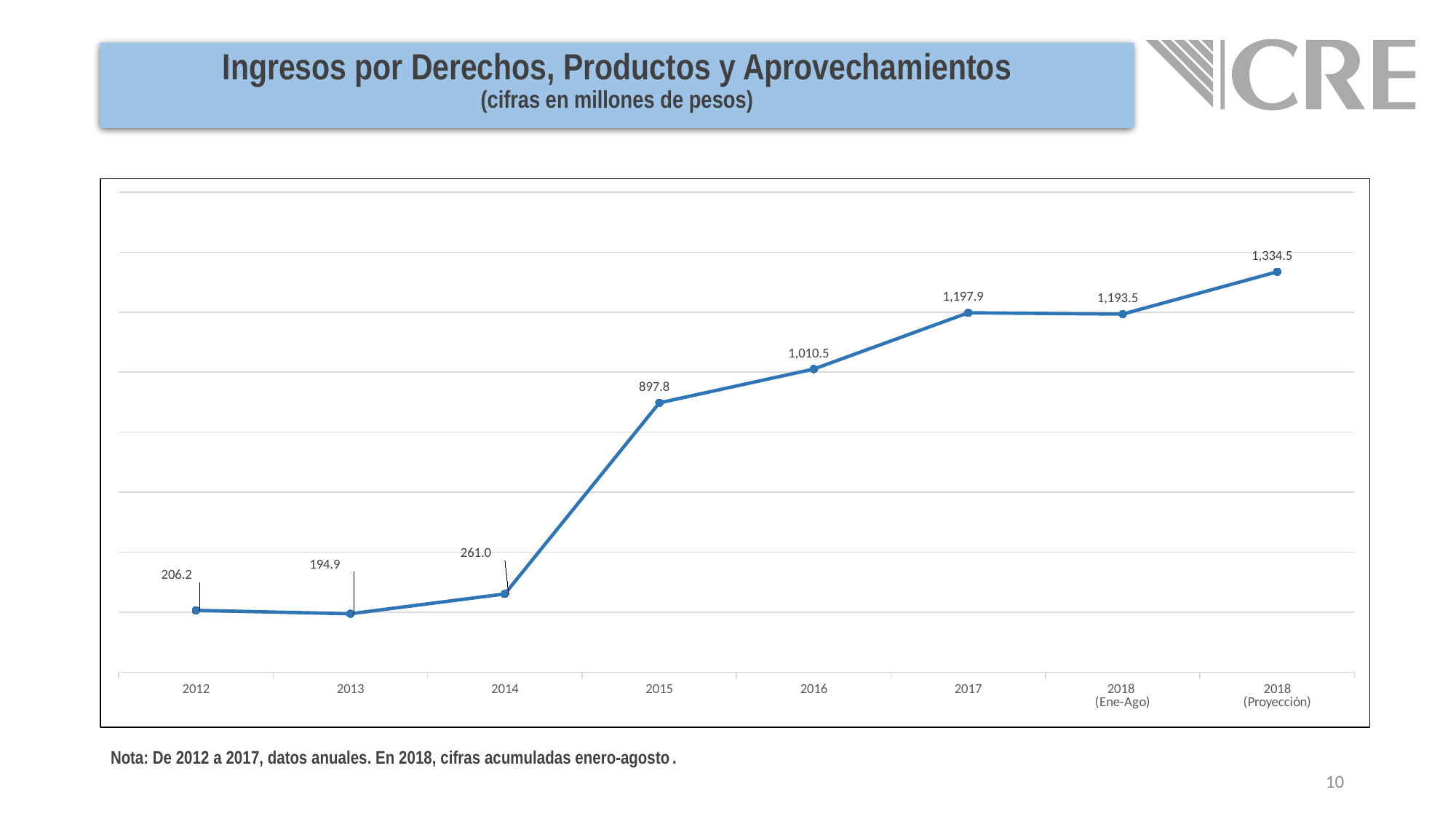
What is the value for 2018 (Proyección)? 1,334.5 Do the values generally rise or fall from 2013 to 2017? rise How many data points are plotted on the chart? 8 What is the title of the chart on the slide? Ingresos por Derechos, Productos y Aprovechamientos (cifras en millones de pesos) What is the difference between the values for 2014 and 2013? 66.1 Which category has the highest value? 2018 (Proyección) What kind of chart is shown on the slide? line chart Which is larger, the value for 2017 or the value for 2018 (Ene-Ago)? 2017 What is the value for 2015? 897.8 Which category has the lowest value? 2013 What is the difference between the values for 2016 and 2015? 112.7 What is the value for 2013? 194.9